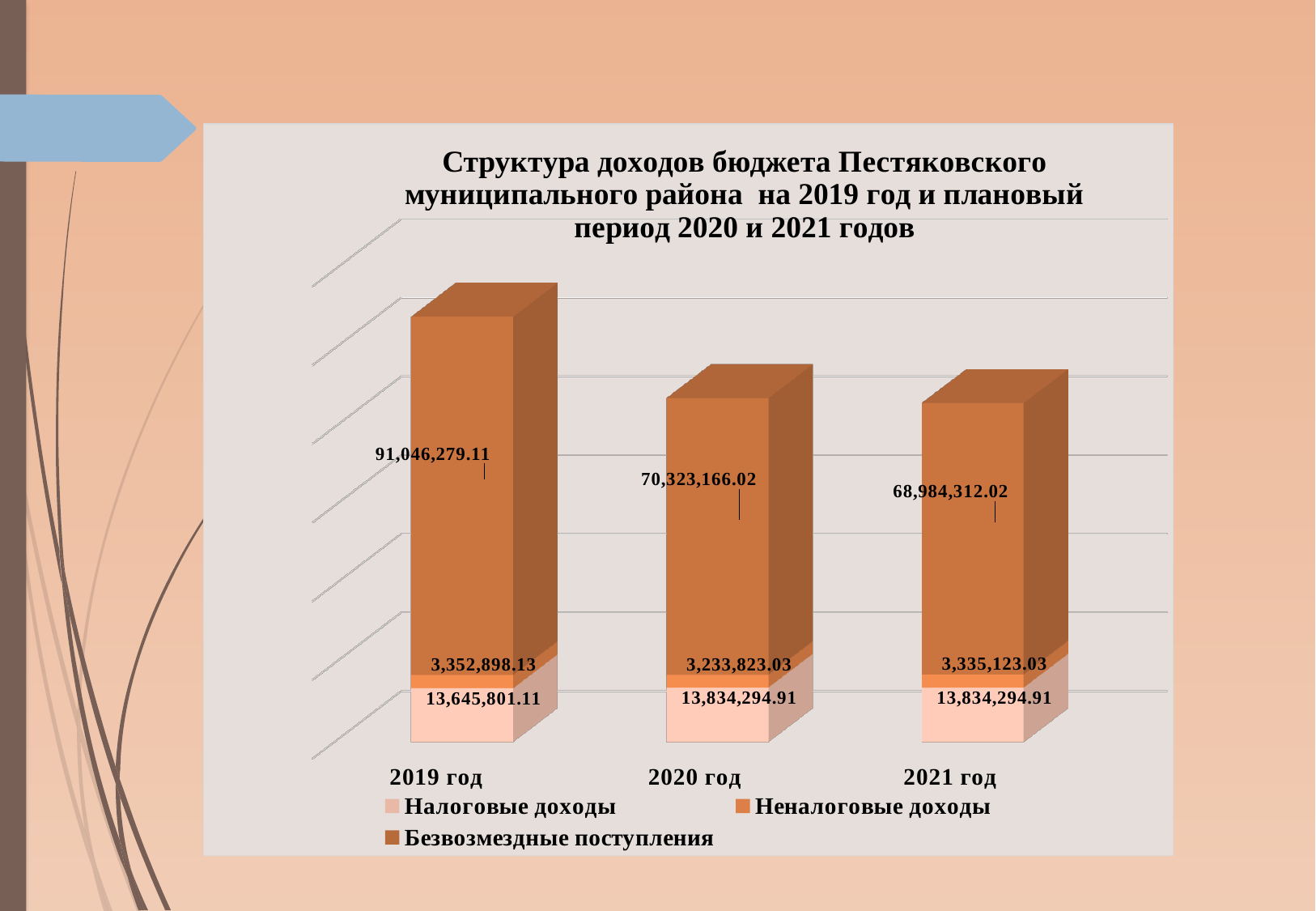
How many series does the legend list? 3 What type of chart is shown on the slide? Stacked bar chart What is the total of the stacked bar for 2020 год? 87,391,283.96 What is the value of Налоговые доходы for 2020 год? 13,834,294.91 In which year is Неналоговые доходы the lowest? 2020 год What is the value of Неналоговые доходы for 2021 год? 3,335,123.03 What is the value of Безвозмездные поступления for 2021 год? 68,984,312.02 What is the value of Безвозмездные поступления for 2019 год? 91,046,279.11 How many years (categories) are shown on the x axis? 3 In which year is Безвозмездные поступления the highest? 2019 год What is the difference between Безвозмездные поступления in 2019 год and 2020 год? 20,723,113.09 Which is larger: Налоговые доходы in 2019 год or in 2020 год? 2020 год